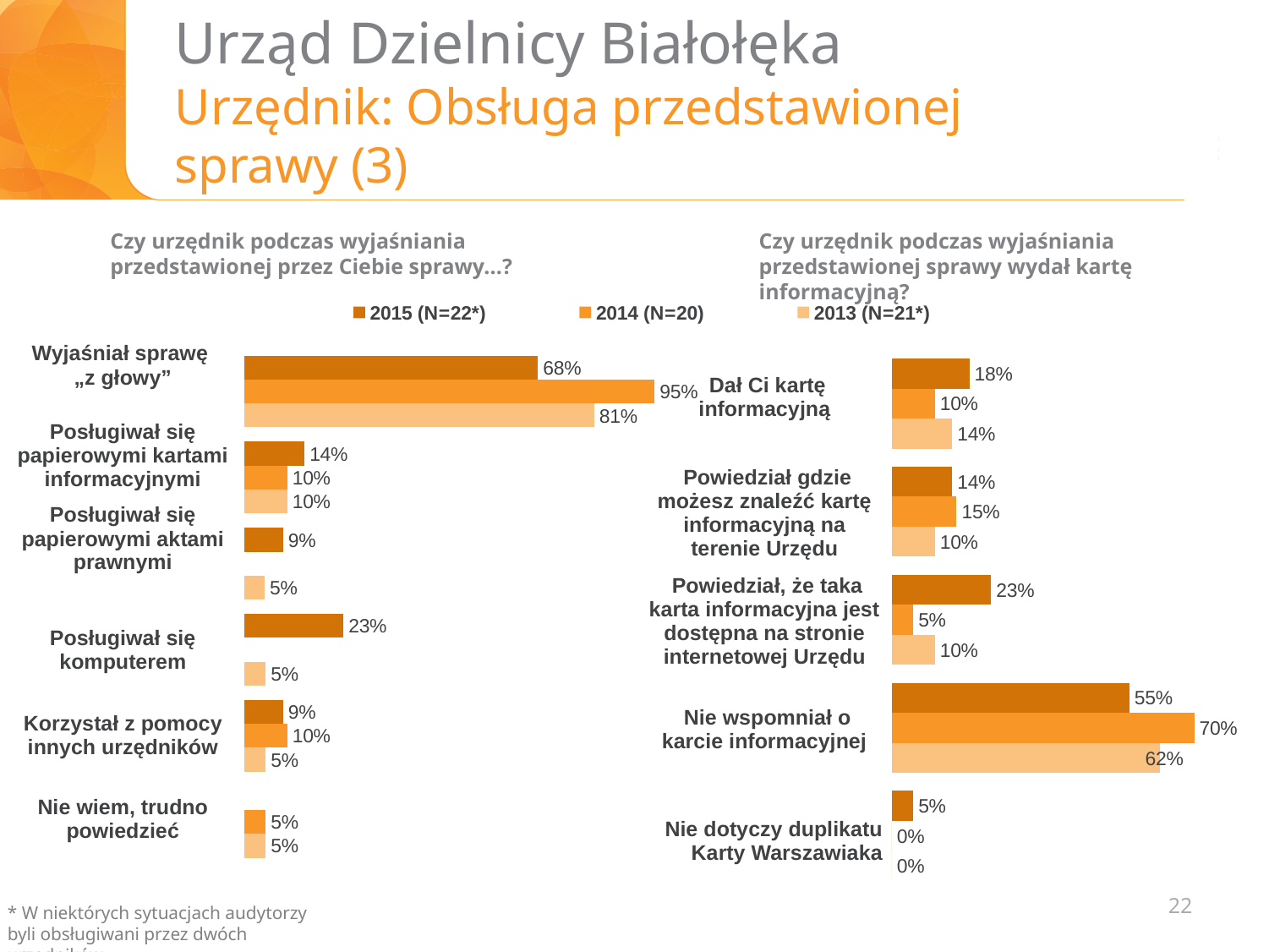
In the left chart ("Czy urzędnik podczas wyjaśniania przedstawionej przez Ciebie sprawy...?"), what is the 2014 (N=20) value for "Wyjaśniał sprawę „z głowy”"? 95% In the left chart, which category has the highest 2015 (N=22*) value? Wyjaśniał sprawę „z głowy” How many series does the legend list? 3 In the right chart, what is the difference between the 2014 (N=20) and 2015 (N=22*) values for "Nie wspomniał o karcie informacyjnej"? 15% In the left chart, what is the 2015 (N=22*) value for "Posługiwał się komputerem"? 23% What type of chart is the left chart? Bar chart In the left chart, what is the difference between the 2014 (N=20) and 2015 (N=22*) values for "Wyjaśniał sprawę „z głowy”"? 27% In the right chart, which category has the highest 2014 (N=20) value? Nie wspomniał o karcie informacyjnej In the right chart, what is the 2015 (N=22*) value for "Dał Ci kartę informacyjną"? 18% How many categories does the right chart show? 5 In the right chart ("Czy urzędnik podczas wyjaśniania przedstawionej sprawy wydał kartę informacyjną?"), what is the 2013 (N=21*) value for "Nie wspomniał o karcie informacyjnej"? 62% In the right chart, for "Powiedział, że taka karta informacyjna jest dostępna na stronie internetowej Urzędu", which year has the larger value: 2015 (N=22*) or 2013 (N=21*)? 2015 (N=22*)